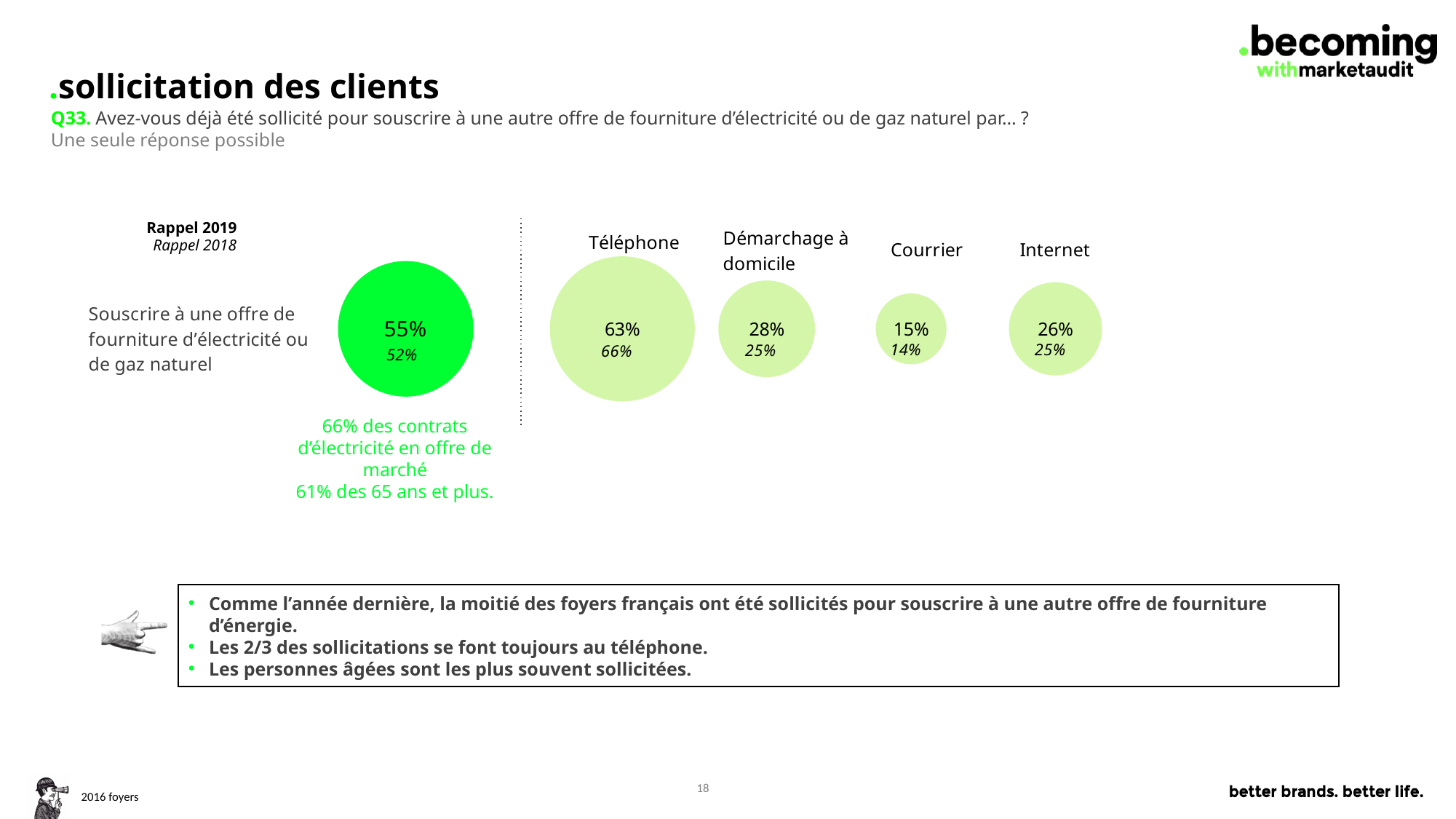
What is the 2019 value for solicitation by Téléphone? 63% How many solicitation channels are shown to the right of the dotted line? 4 What percentage of respondents have been solicited to subscribe to another electricity or natural gas supply offer (2019 value in the large green bubble)? 55% Which solicitation channel has the lowest 2019 value? Courrier Which solicitation channel has the highest 2019 value? Téléphone Which has a higher 2019 value, Démarchage à domicile or Internet? Démarchage à domicile What kind of chart is used to display the values on this slide? Bubble chart What was the 2018 recall value (Rappel 2018) for being solicited to subscribe to another electricity or gas offer? 52% What is the 2018 recall value for solicitation by Courrier? 14% What is the 2019 value for solicitation by Internet? 26% What is the 2019 value for solicitation by Démarchage à domicile? 28% What is the difference between the 2019 values for Téléphone and Démarchage à domicile? 35 percentage points